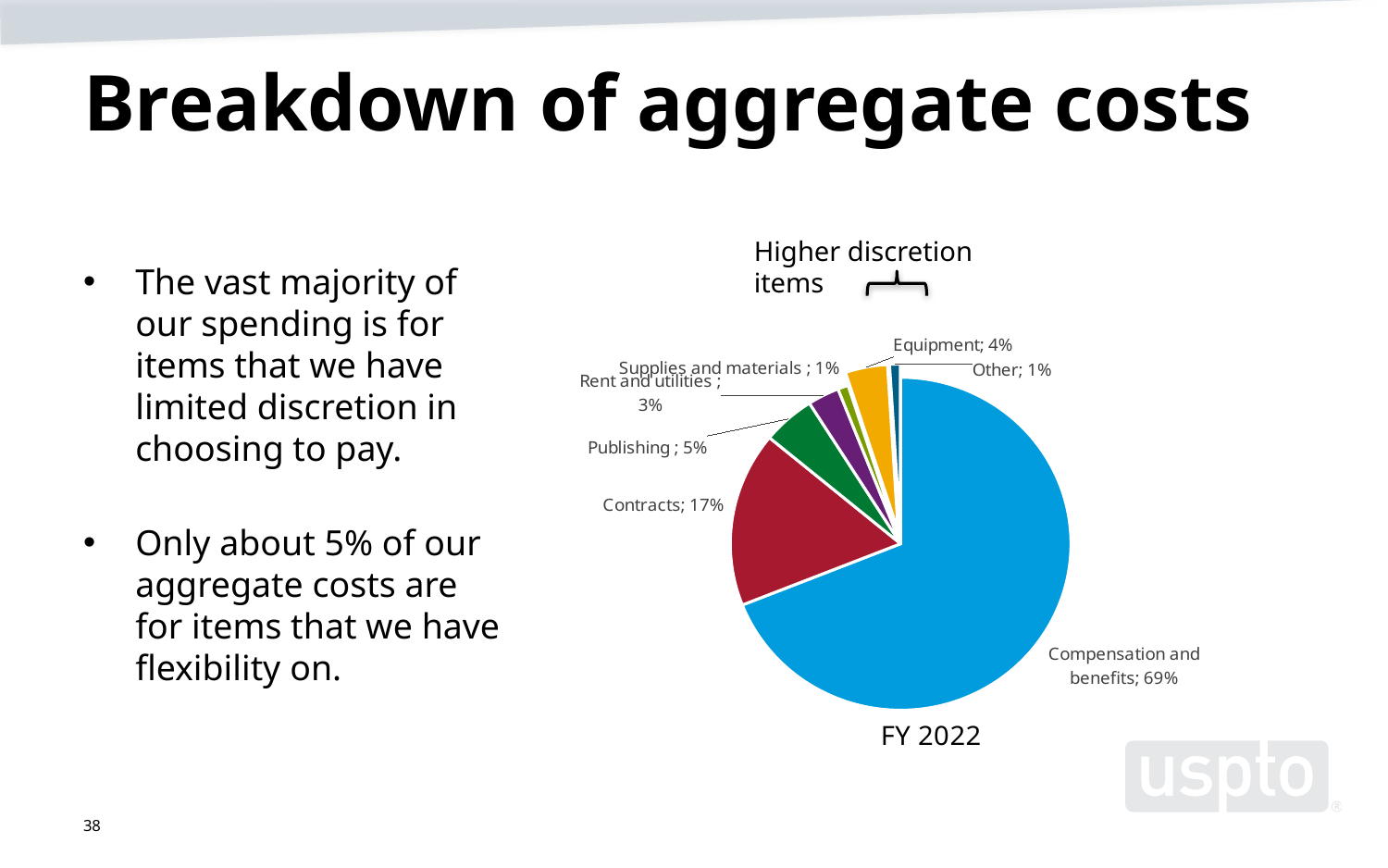
What share of aggregate costs is Equipment? 4% What share of aggregate costs is Compensation and benefits? 69% Which category has the largest share of the pie? Compensation and benefits What share of aggregate costs is Rent and utilities? 3% What kind of chart is shown on the slide? Pie chart What share of aggregate costs is Contracts? 17% What share of aggregate costs is Publishing? 5% What fiscal year is labelled below the pie chart? FY 2022 How many slices does the pie chart have? 7 What is the difference in percentage points between Compensation and benefits and Contracts? 52 What is the difference in percentage points between Contracts and Publishing? 12 Which is larger, the share for Publishing or the share for Equipment? Publishing